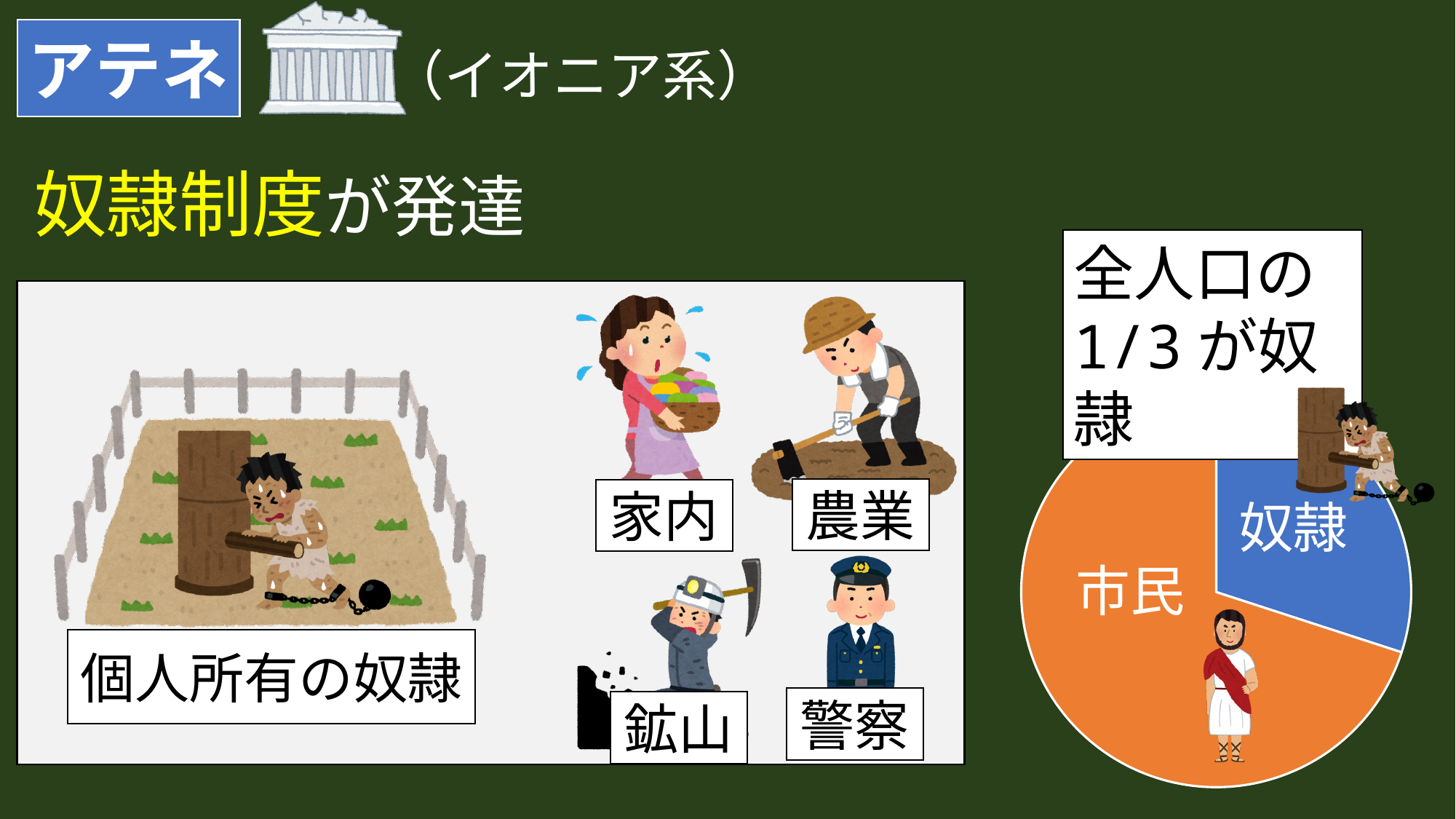
Which slice of the pie chart is the smallest? 奴隷 What colour is the 奴隷 slice in the pie chart? blue In the pie chart, which is larger, 市民 or 奴隷? 市民 What kind of chart is shown on the right side of the slide? pie chart How many slices does the pie chart have? 2 What colour is the 市民 slice in the pie chart? orange According to the slide, what share of the total population does the 奴隷 slice represent? 1/3 Which slice of the pie chart is the largest? 市民